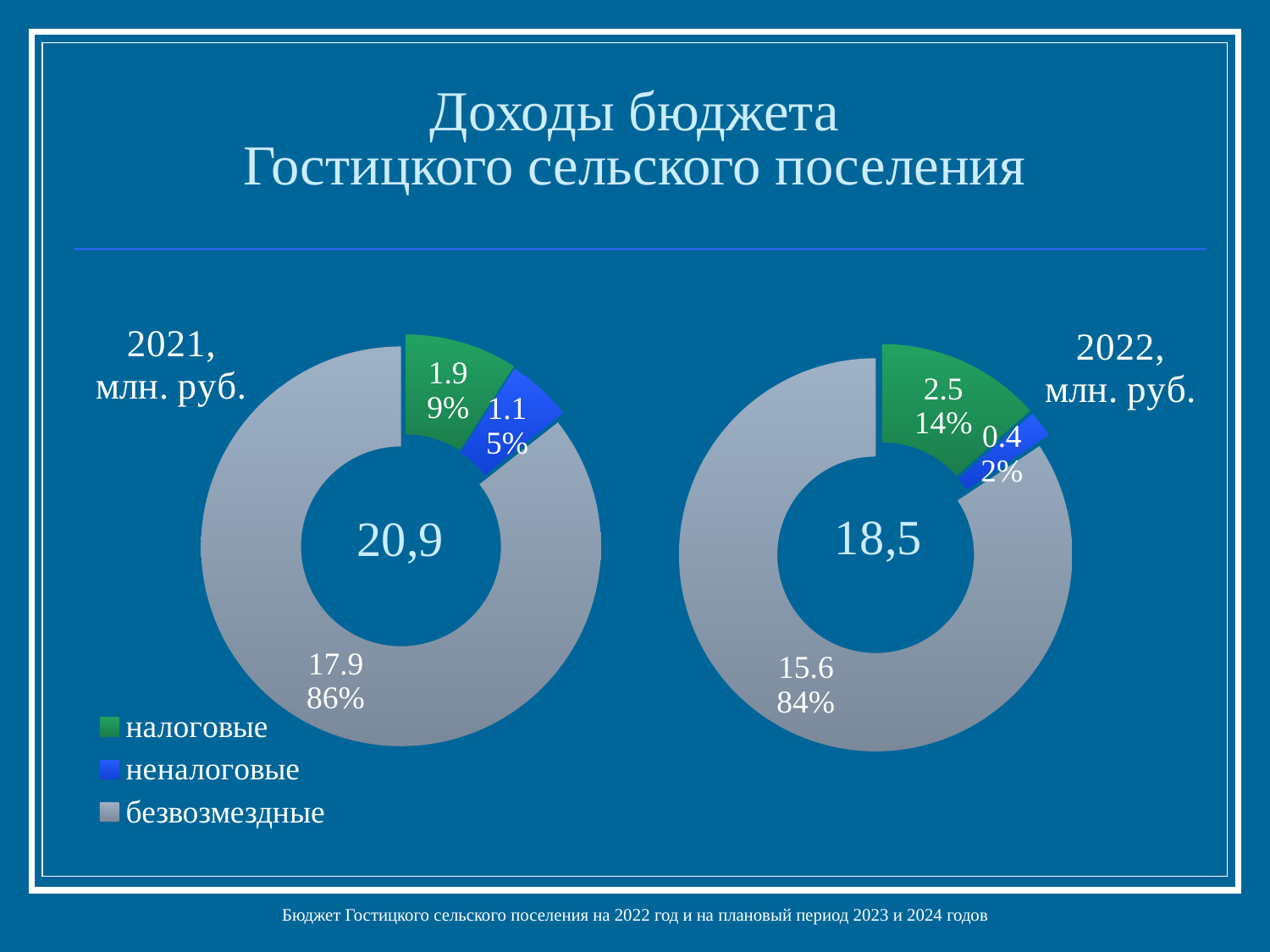
In the 2022 chart, what is the value for безвозмездные? 15.6 In the 2021 chart, what share of the total do неналоговые revenues make up? 5% How many categories does each chart show? 3 In the 2022 chart, what share of the total do налоговые revenues make up? 14% Which is larger: the налоговые value in the 2021 chart or in the 2022 chart? 2022 What is the difference between the безвозмездные value in the 2021 chart and in the 2022 chart? 2.3 In the 2021 chart, which category has the largest value? безвозмездные In the 2022 chart, which category has the smallest value? неналоговые What total is shown in the centre of the 2022 chart? 18,5 What kind of chart is used on this slide? doughnut chart In the 2021 chart, what is the value for налоговые? 1.9 Which colour represents неналоговые in the legend? blue